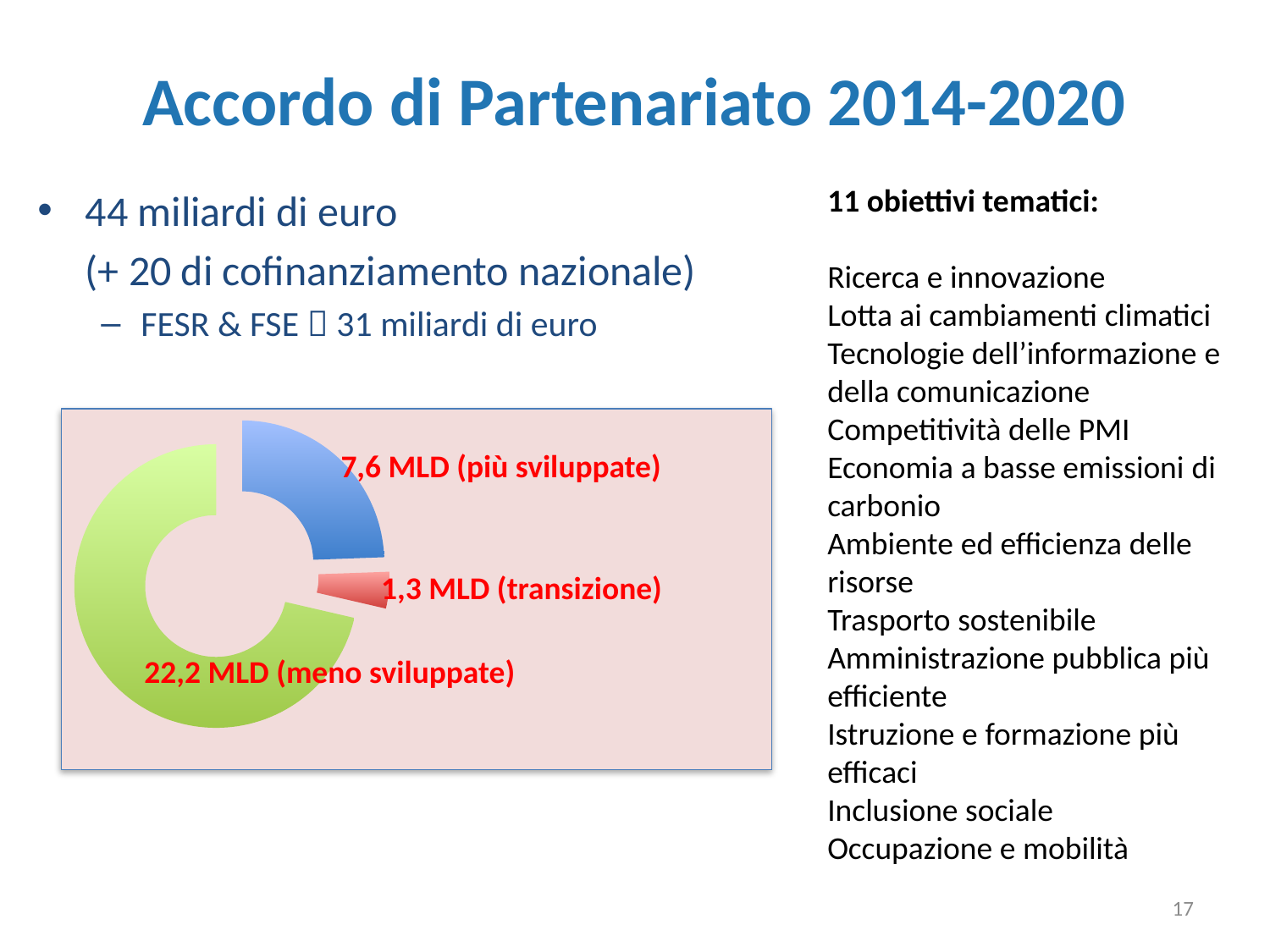
What value does the chart show for the 'più sviluppate' regions? 7,6 MLD Which is larger, the value for 'più sviluppate' or for 'transizione'? più sviluppate Which category has the smallest value in the chart? transizione What kind of chart is shown on the slide? Doughnut (pie) chart How many categories are shown in the chart? 3 What colour is the segment for 'meno sviluppate'? Green What is the difference between the 'meno sviluppate' and 'più sviluppate' values? 14,6 MLD What is the total of the three values shown in the chart? 31,1 MLD What is the difference between the 'più sviluppate' and 'transizione' values? 6,3 MLD What value does the chart show for the 'transizione' regions? 1,3 MLD What value does the chart show for the 'meno sviluppate' regions? 22,2 MLD Which category has the largest value in the chart? meno sviluppate